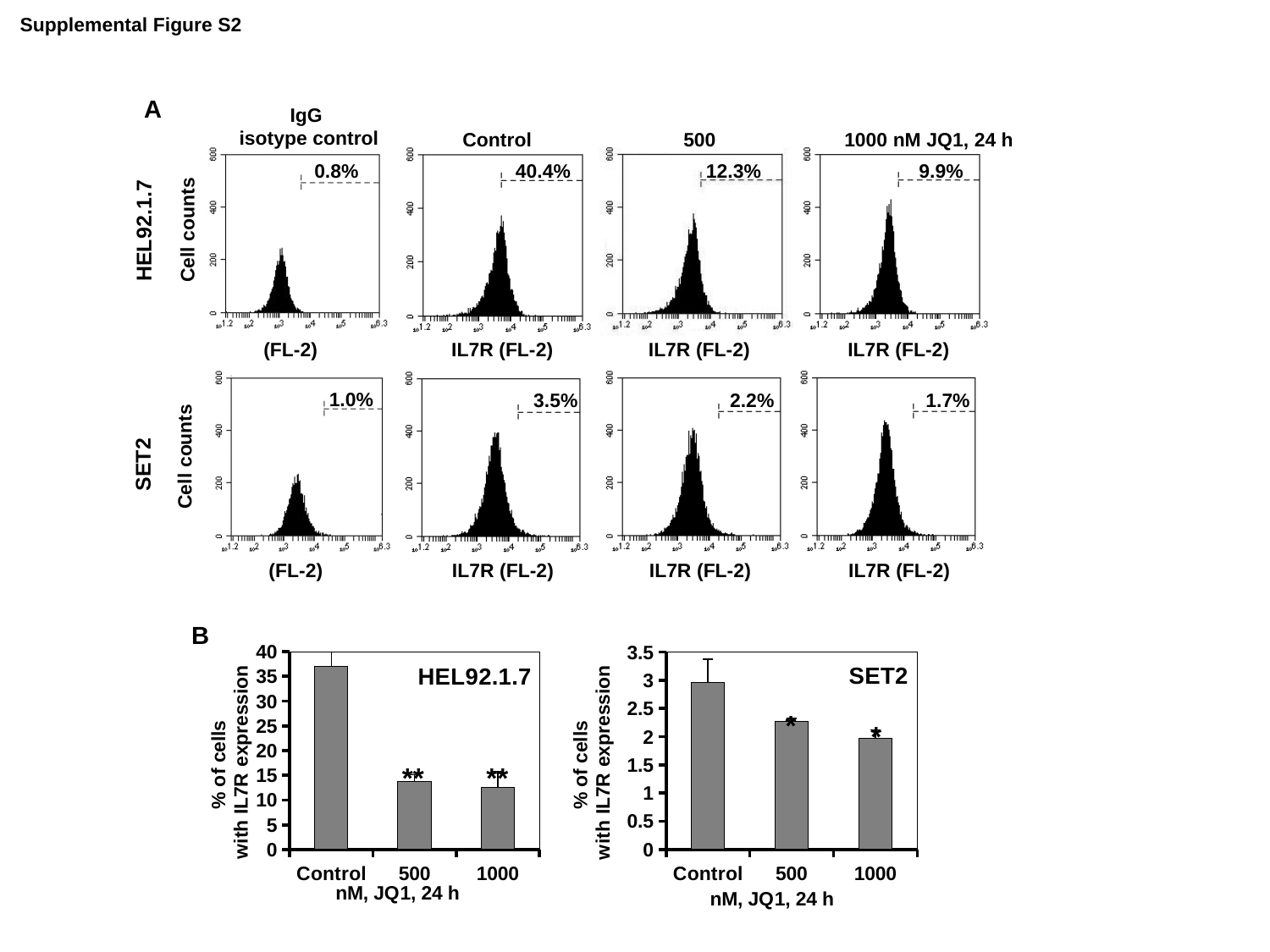
In panel B, in the SET2 chart, is the value for 1000 nM JQ1 greater or less than 2.5? less In panel A, what percentage is printed on the HEL92.1.7 histogram for 1000 nM JQ1, 24 h? 9.9% In panel A, what percentage is printed on the SET2 histogram for 500 nM JQ1? 2.2% In panel A, which SET2 histogram shows the lowest printed percentage? IgG isotype control In panel A, what is the difference between the HEL92.1.7 Control percentage and the HEL92.1.7 500 nM JQ1 percentage? 28.1% In panel B, in the HEL92.1.7 chart, do the values rise or fall from Control to 1000 nM JQ1? Fall In panel A, what percentage is printed on the SET2 Control histogram? 3.5% In panel A, which HEL92.1.7 histogram shows the highest printed percentage? Control In panel B, what kind of chart is the HEL92.1.7 chart? Bar chart In panel A, what percentage is printed on the HEL92.1.7 Control histogram? 40.4% In panel B, in the HEL92.1.7 chart, is the value for Control greater or less than 30? greater In panel B, how many bars does the SET2 chart have? 3